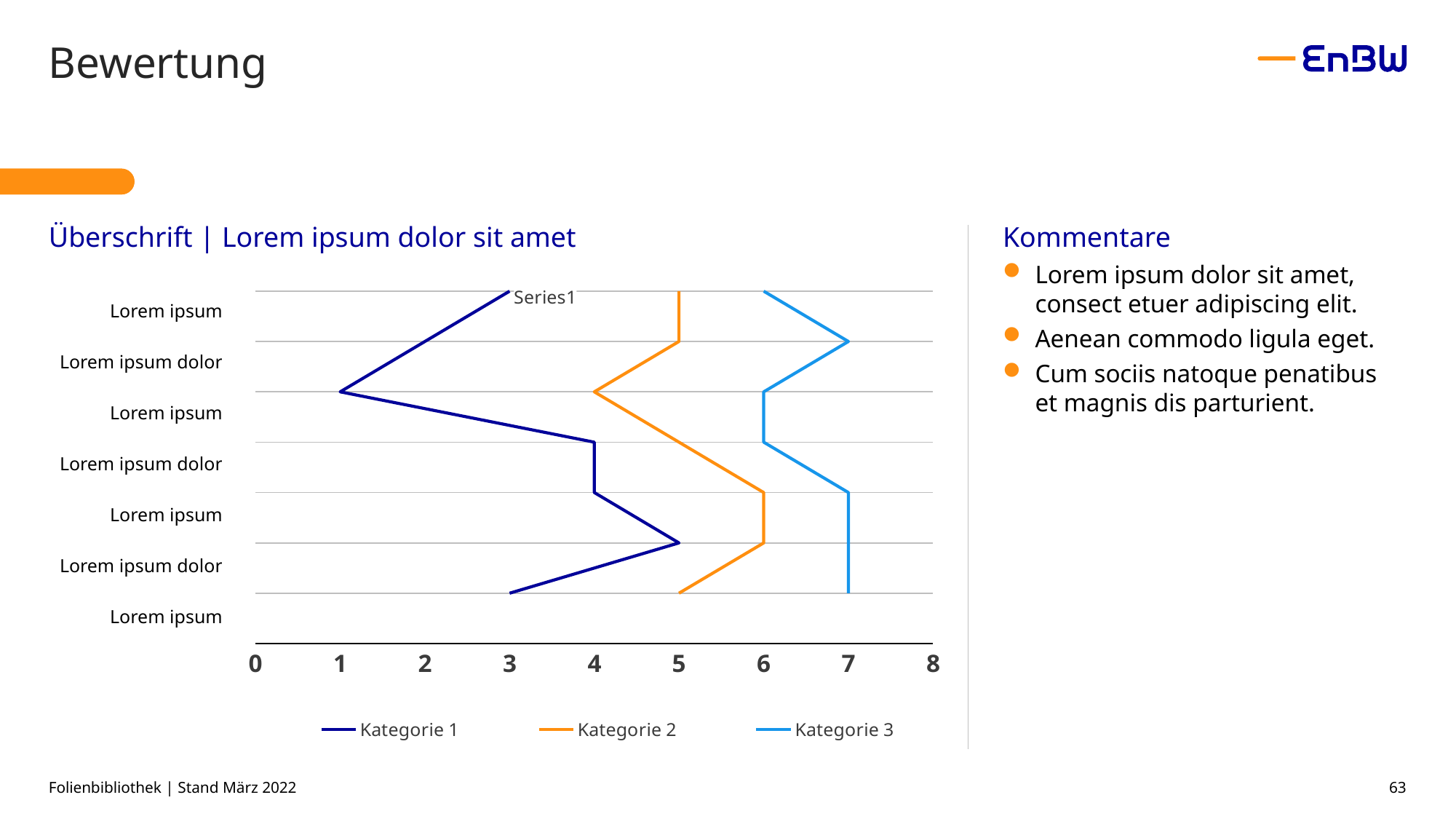
What is the value of Kategorie 2 at the bottom category of the chart? 5 What is the lowest value reached by the Kategorie 1 line? 1 What is the maximum value shown on the horizontal axis? 8 What is the value of Kategorie 1 at the bottom category of the chart? 3 How many series does the legend list? 3 At the bottom category, what is the difference between the Kategorie 3 value and the Kategorie 1 value? 4 What kind of chart is shown on the slide? line chart What are the names of the series in the legend? Kategorie 1, Kategorie 2, Kategorie 3 What is the highest value reached by the Kategorie 3 line? 7 What is the value of Kategorie 3 at the bottom category of the chart? 7 At the bottom category, which series has the larger value, Kategorie 1 or Kategorie 3? Kategorie 3 How many category labels are shown on the vertical axis? 7